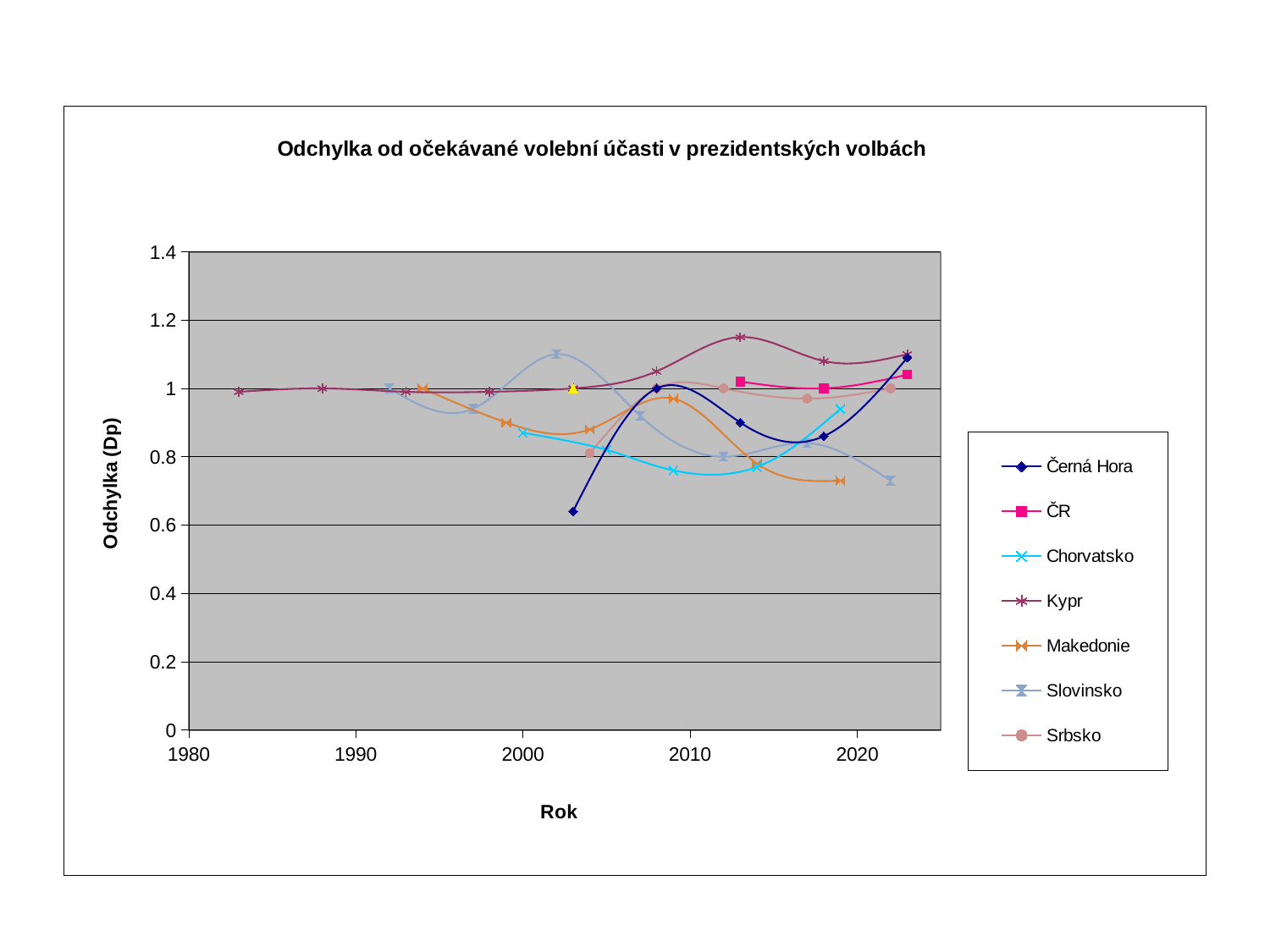
What kind of chart is shown on the slide? line chart Is the highest value for Kypr greater or less than 1? greater Does the Slovinsko line rise or fall from its peak around 2002 to its last point around 2022? fall What is the label of the vertical axis? Odchylka (Dp) Is the last (latest) value for Makedonie greater or less than 0.8? less Around 2013, which series has the larger value, Kypr or Chorvatsko? Kypr How many series does the legend list? 7 What is the title of the chart? Odchylka od očekávané volební účasti v prezidentských volbách Which series has the lowest point on the chart? Černá Hora Is the first (earliest) value for Černá Hora greater or less than 0.8? less